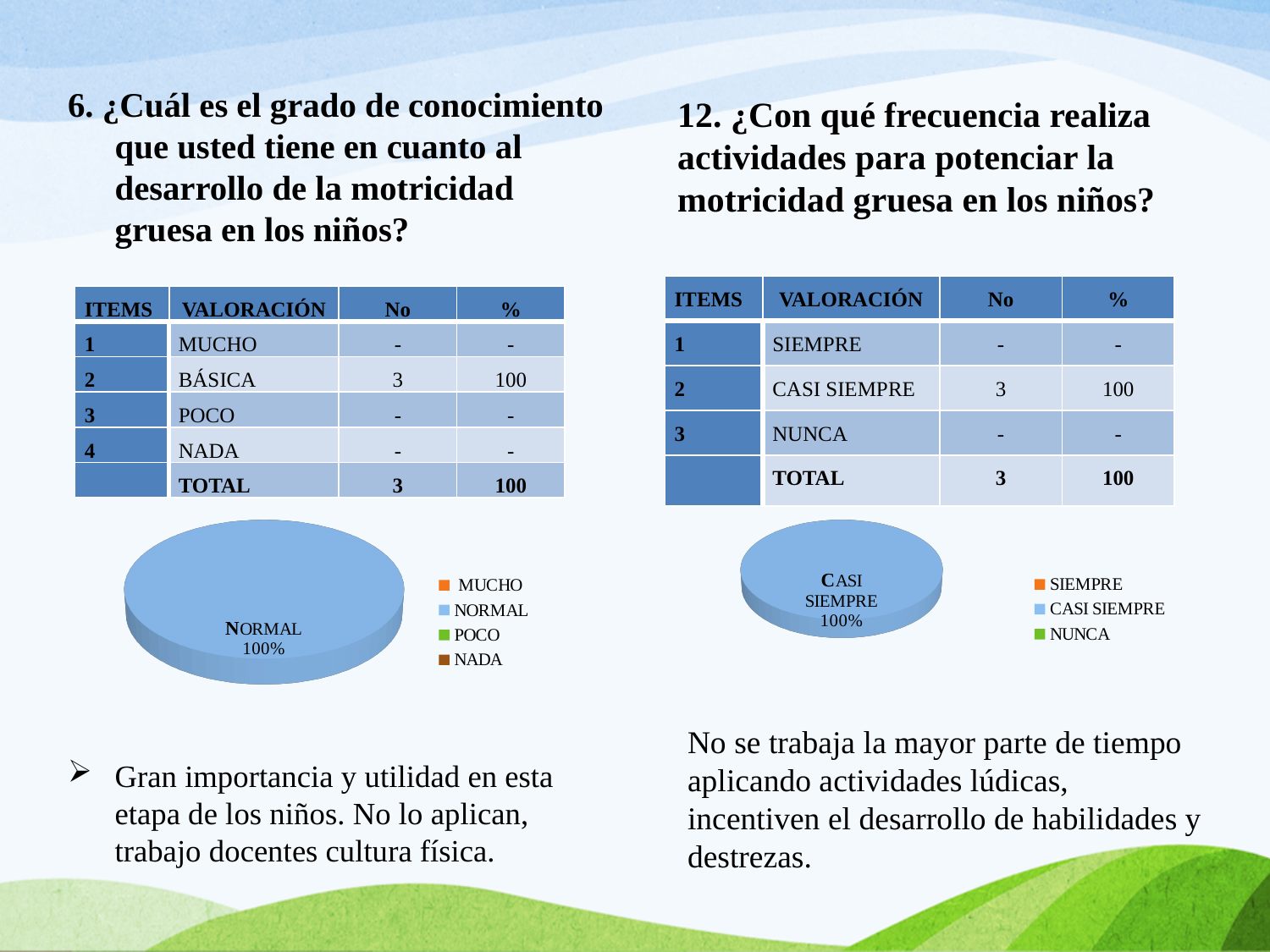
In the right pie chart (question 12), which category is the largest slice? CASI SIEMPRE What kind of chart is shown on the right side of the slide, under question 12? pie chart In the right pie chart (question 12), which legend entry is shown with an orange marker? SIEMPRE In the right pie chart (question 12), how many slices are actually visible in the pie? 1 In the left pie chart (question 6), which legend entry is shown with a green marker? POCO In the right pie chart (question 12), what share of the pie does the CASI SIEMPRE slice take? 100% How many entries does the legend of the left pie chart (question 6) list? 4 In the left pie chart (question 6), which category is the largest slice? NORMAL What kind of chart is shown on the left side of the slide, under question 6? pie chart How many entries does the legend of the right pie chart (question 12) list? 3 In the left pie chart (question 6), how many slices are actually visible in the pie? 1 In the left pie chart (question 6), what share of the pie does the NORMAL slice take? 100%